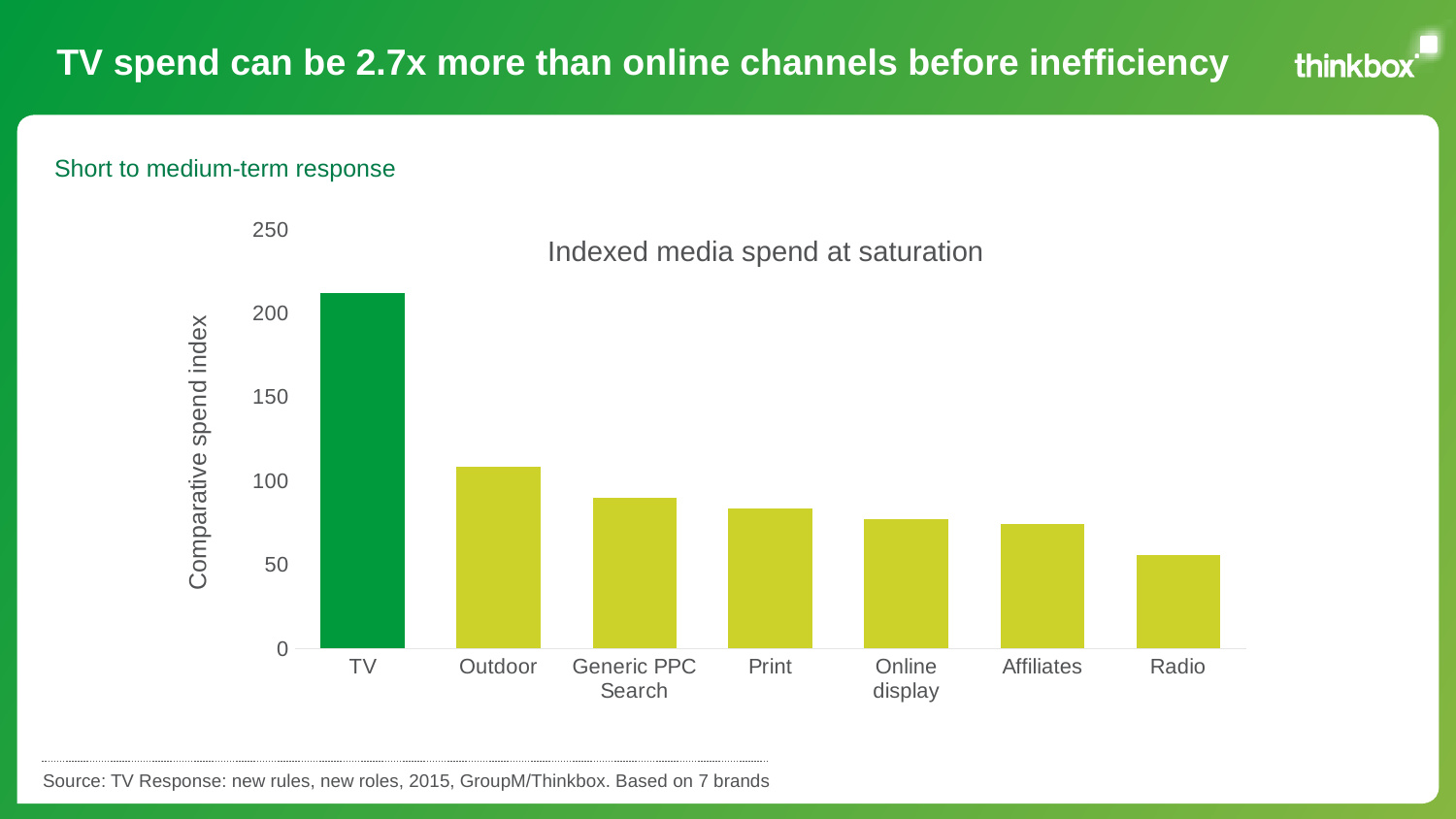
Is the value for Generic PPC Search greater or less than 100? less Which channel has the highest comparative spend index? TV What is the title of the chart? Indexed media spend at saturation Which is larger, the value for Outdoor or the value for Radio? Outdoor Is the value for Affiliates greater or less than 50? greater What kind of chart is shown on the slide? bar chart Do the values rise or fall moving from left to right along the x axis? fall Is the value for Outdoor greater or less than 100? greater Which channel has the lowest comparative spend index? Radio What is the label on the y axis? Comparative spend index How many channels are shown on the x axis? 7